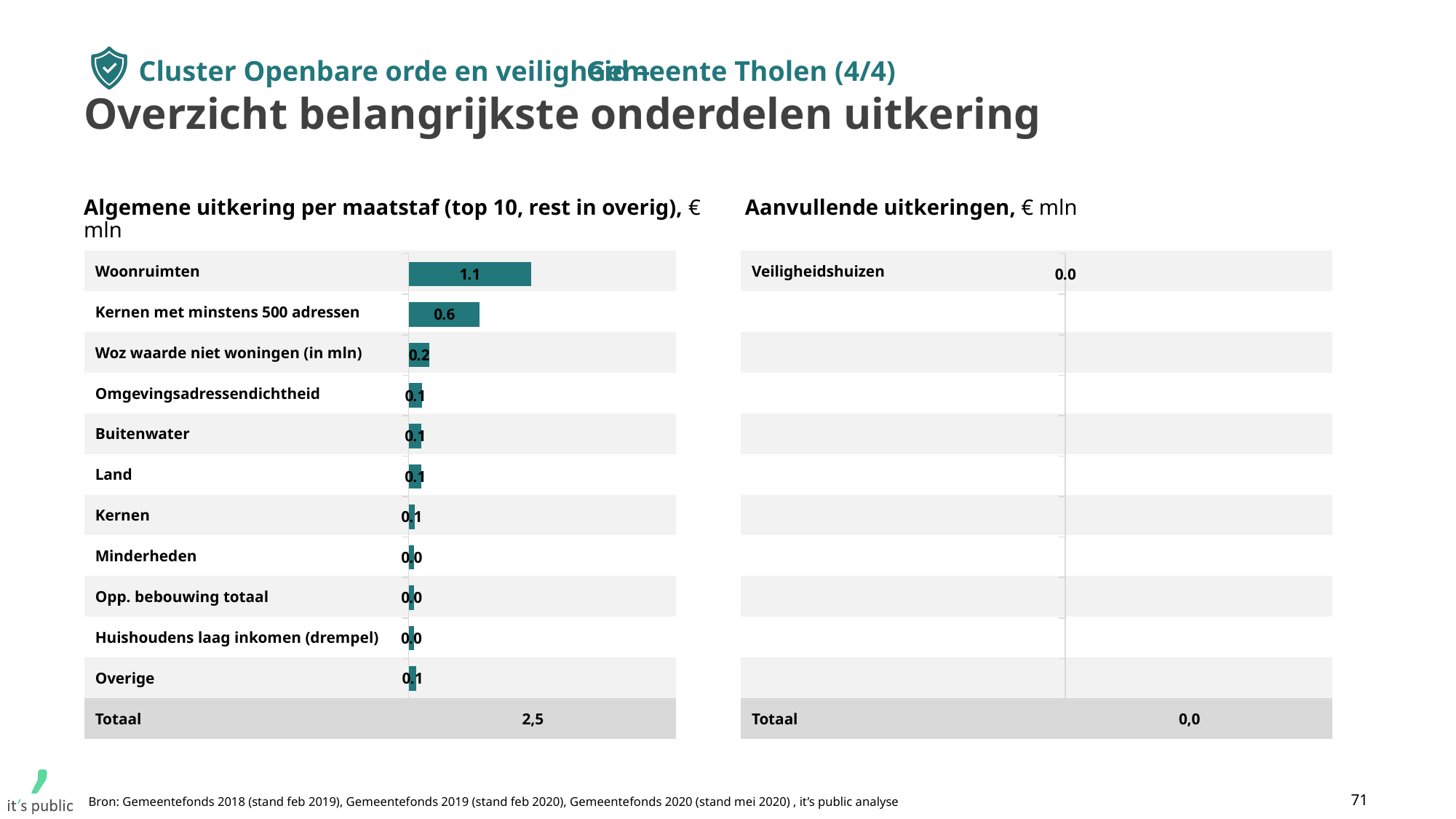
In the chart 'Algemene uitkering per maatstaf', how many categories are listed above the Totaal row? 11 In the chart 'Aanvullende uitkeringen', what is the Totaal value? 0,0 In the chart 'Algemene uitkering per maatstaf', what is the difference between Woonruimten and Kernen met minstens 500 adressen? 0.5 In the chart 'Algemene uitkering per maatstaf', which category has the highest value? Woonruimten In the chart 'Algemene uitkering per maatstaf', what is the value for Woz waarde niet woningen (in mln)? 0.2 What kind of chart is 'Algemene uitkering per maatstaf'? Bar chart In the chart 'Algemene uitkering per maatstaf', what is the value for Kernen met minstens 500 adressen? 0.6 In the chart 'Algemene uitkering per maatstaf', what is the value for Woonruimten? 1.1 In the chart 'Algemene uitkering per maatstaf', what is the value for Minderheden? 0.0 In the chart 'Algemene uitkering per maatstaf', which is larger: Kernen met minstens 500 adressen or Woz waarde niet woningen (in mln)? Kernen met minstens 500 adressen In the chart 'Algemene uitkering per maatstaf', what is the Totaal value? 2,5 In the chart 'Aanvullende uitkeringen', what is the value for Veiligheidshuizen? 0.0